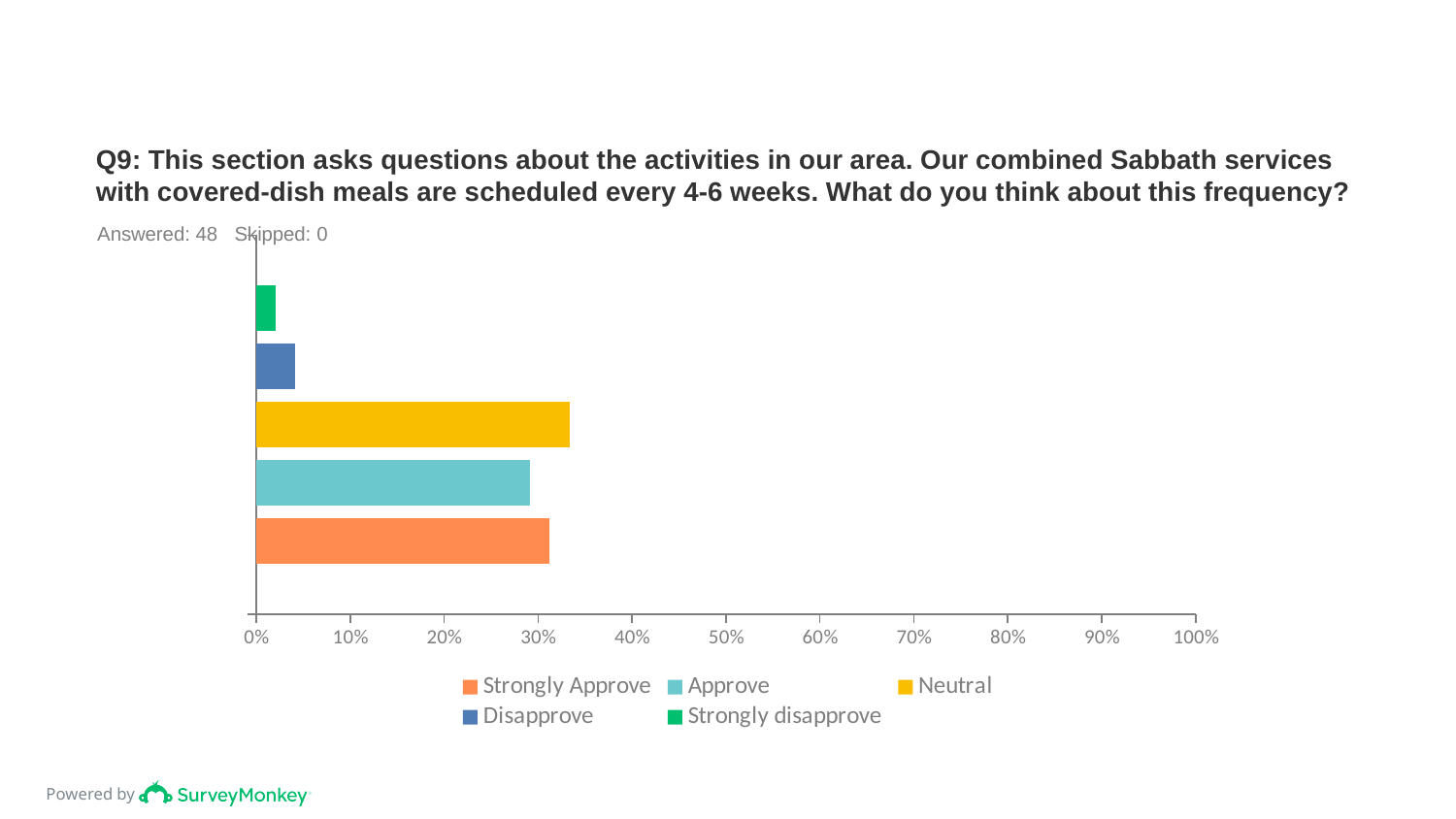
How many bars are plotted in the chart? 5 Which is larger, the value for Neutral or the value for Disapprove? Neutral How many entries does the chart's legend list? 5 How many respondents answered this question according to the slide? 48 Is the value for Neutral greater or less than 30%? greater Which is larger, the value for Disapprove or the value for Strongly disapprove? Disapprove Which response option has the lowest value in the chart? Strongly disapprove Is the value for Disapprove greater or less than 10%? less What kind of chart is shown on the slide? bar chart Which response option has the highest value in the chart? Neutral Is the value for Approve greater or less than 20%? greater